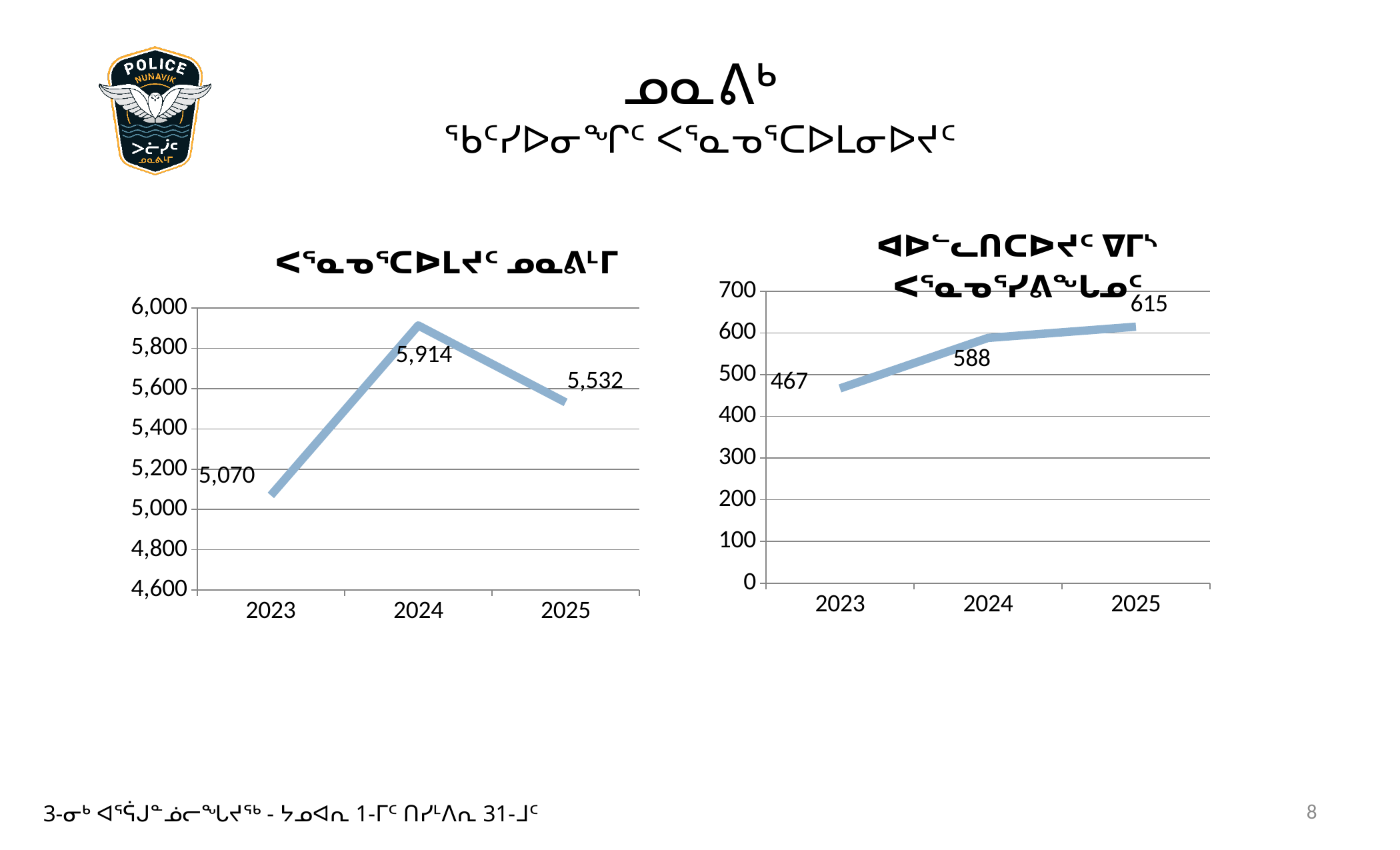
In the left chart, what is the value for 2023? 5,070 In the right chart, what is the value for 2023? 467 In the right chart, which year has the lowest value? 2023 How many data points are plotted in the right chart? 3 In the right chart, what is the value for 2025? 615 In the left chart, which is larger, the value for 2023 or the value for 2025? 2025 In the left chart, which year has the highest value? 2024 What kind of chart is the left chart? line chart In the left chart, what is the value for 2024? 5,914 In the right chart, what is the difference between the 2024 and 2023 values? 121 In the left chart, what is the difference between the 2024 and 2025 values? 382 In the right chart, do the values rise or fall from 2023 to 2025? rise